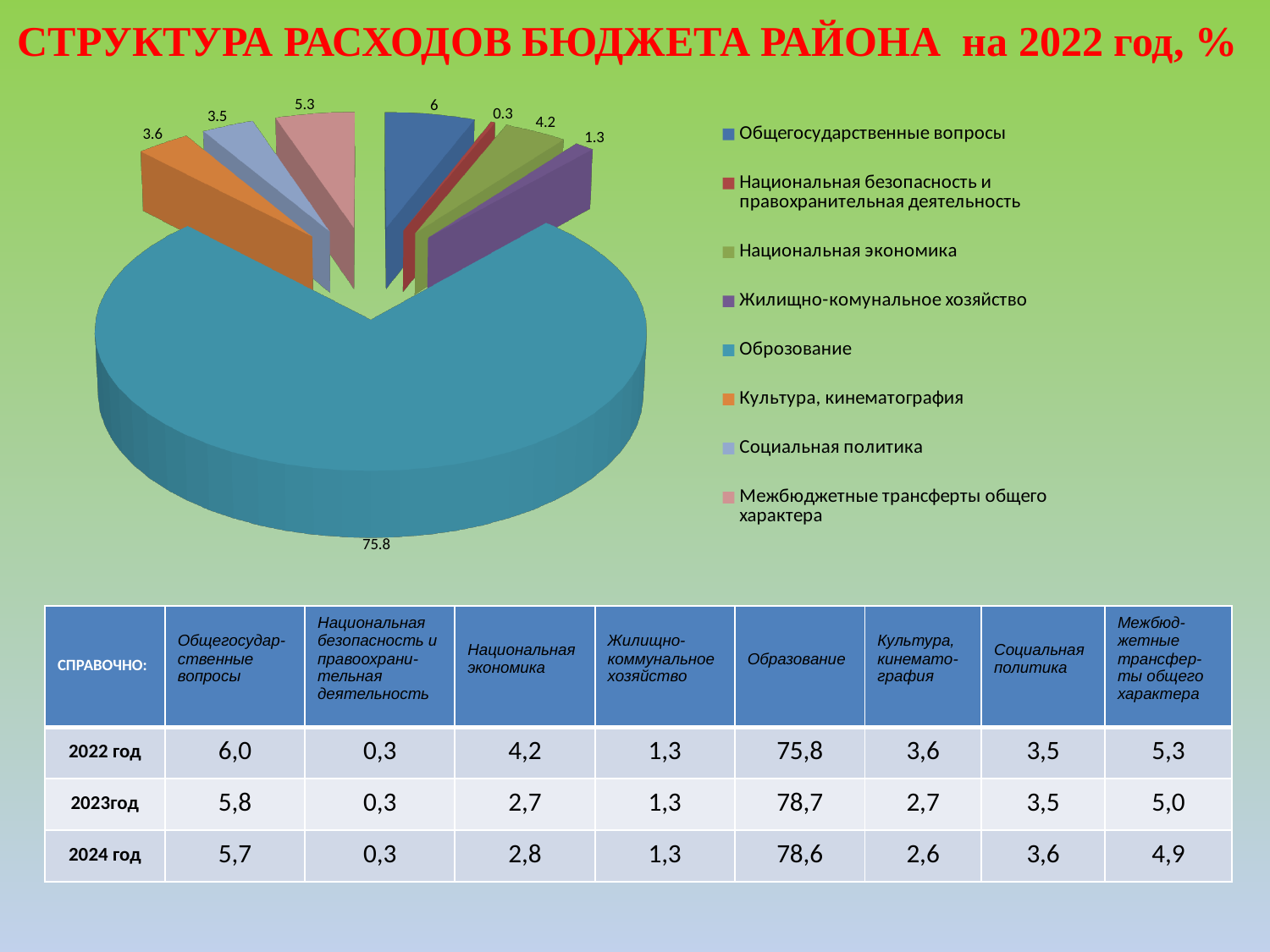
What is the value for Образование in the pie chart? 75.8 Which category has the smallest slice in the pie chart? Национальная безопасность и правохранительная деятельность What is the value for Общегосударственные вопросы in the pie chart? 6 What is the value for Национальная экономика in the pie chart? 4.2 What is the value for Межбюджетные трансферты общего характера in the pie chart? 5.3 Which category has the largest slice in the pie chart? Образование What is the title of the chart on the slide? СТРУКТУРА РАСХОДОВ БЮДЖЕТА РАЙОНА на 2022 год, % Which is larger in the pie chart: Социальная политика or Межбюджетные трансферты общего характера? Межбюджетные трансферты общего характера What is the value for Культура, кинематография in the pie chart? 3.6 What kind of chart is shown on the slide? pie chart How many categories does the pie chart legend list? 8 What is the difference between the values for Общегосударственные вопросы and Национальная экономика in the pie chart? 1.8